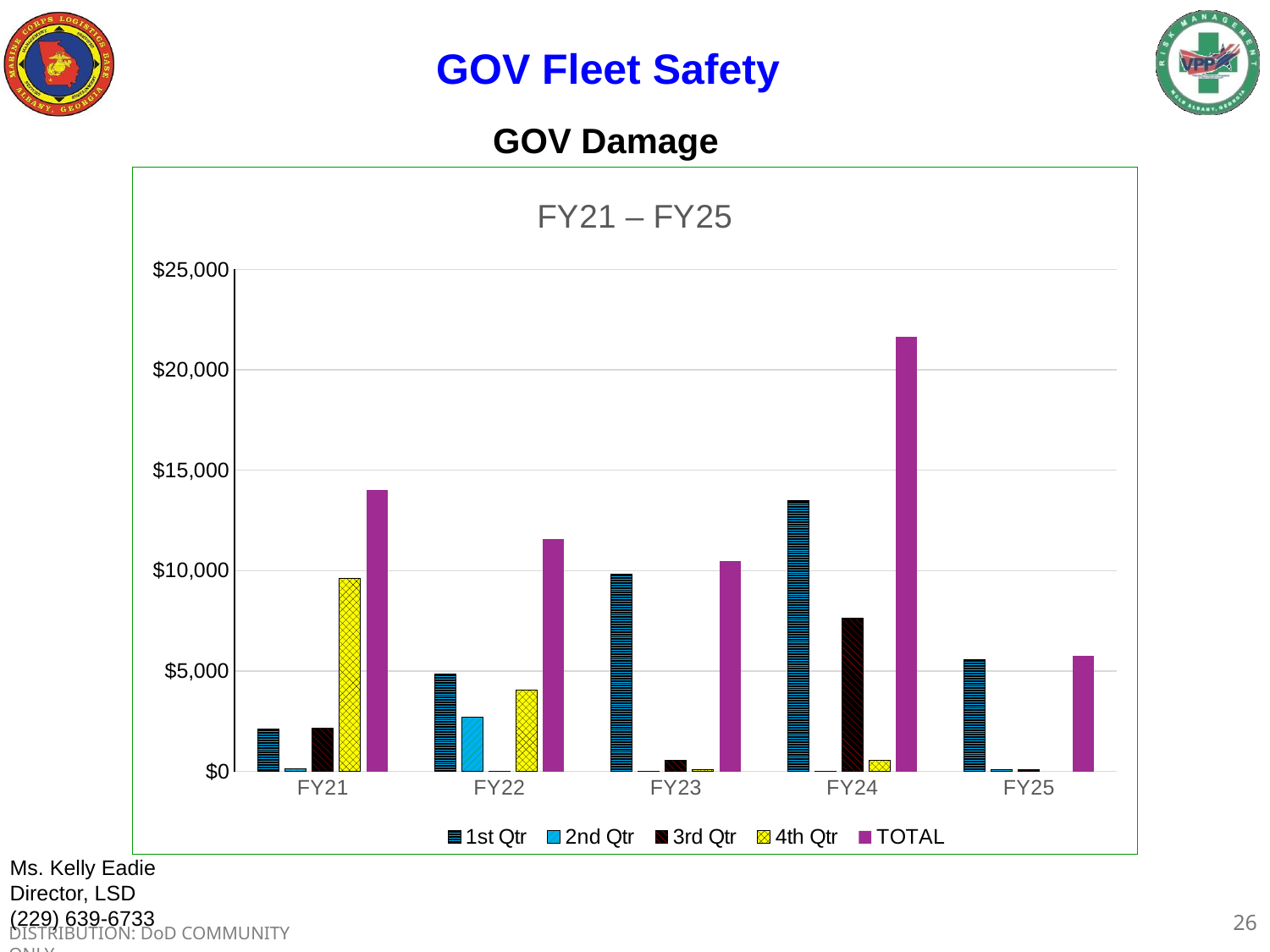
Is the TOTAL value for FY24 greater or less than $20,000? greater Is the TOTAL value for FY22 greater or less than $10,000? greater Is the 1st Qtr value for FY24 greater or less than $10,000? greater What is the title shown inside the chart area? FY21 – FY25 How many series does the legend list? 5 Which fiscal year has the highest TOTAL bar? FY24 Within FY24, which is larger, the 3rd Qtr bar or the 4th Qtr bar? 3rd Qtr Which is larger, the 1st Qtr value for FY23 or the 1st Qtr value for FY22? FY23 How many fiscal years are shown on the x axis? 5 Which fiscal year has the lowest TOTAL bar? FY25 What kind of chart is shown on the slide? Bar chart